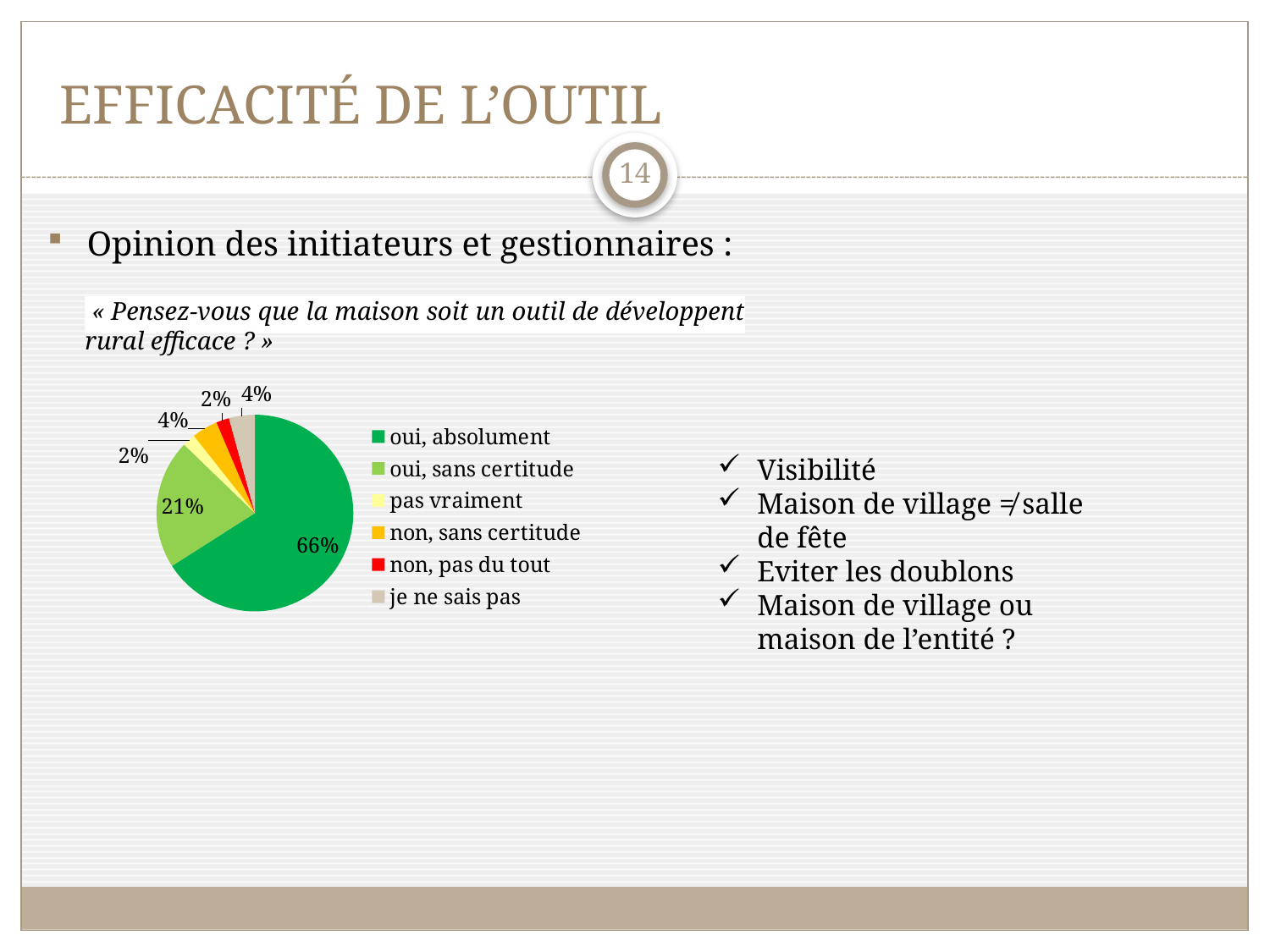
What kind of chart is shown on the slide? pie chart What percentage of respondents answered "non, sans certitude"? 4% Which legend entry is shown in grey? je ne sais pas What colour is the slice for "non, pas du tout"? red What percentage of respondents answered "oui, absolument"? 66% What percentage of respondents answered "je ne sais pas"? 4% How many response categories does the pie chart show? 6 Which response category has the largest share of the pie? oui, absolument What is the difference in percentage points between "oui, absolument" and "oui, sans certitude"? 45 What is the combined share of the two "oui" responses ("oui, absolument" and "oui, sans certitude")? 87% What percentage of respondents answered "oui, sans certitude"? 21% Which is larger: the share for "oui, sans certitude" or the share for "je ne sais pas"? oui, sans certitude